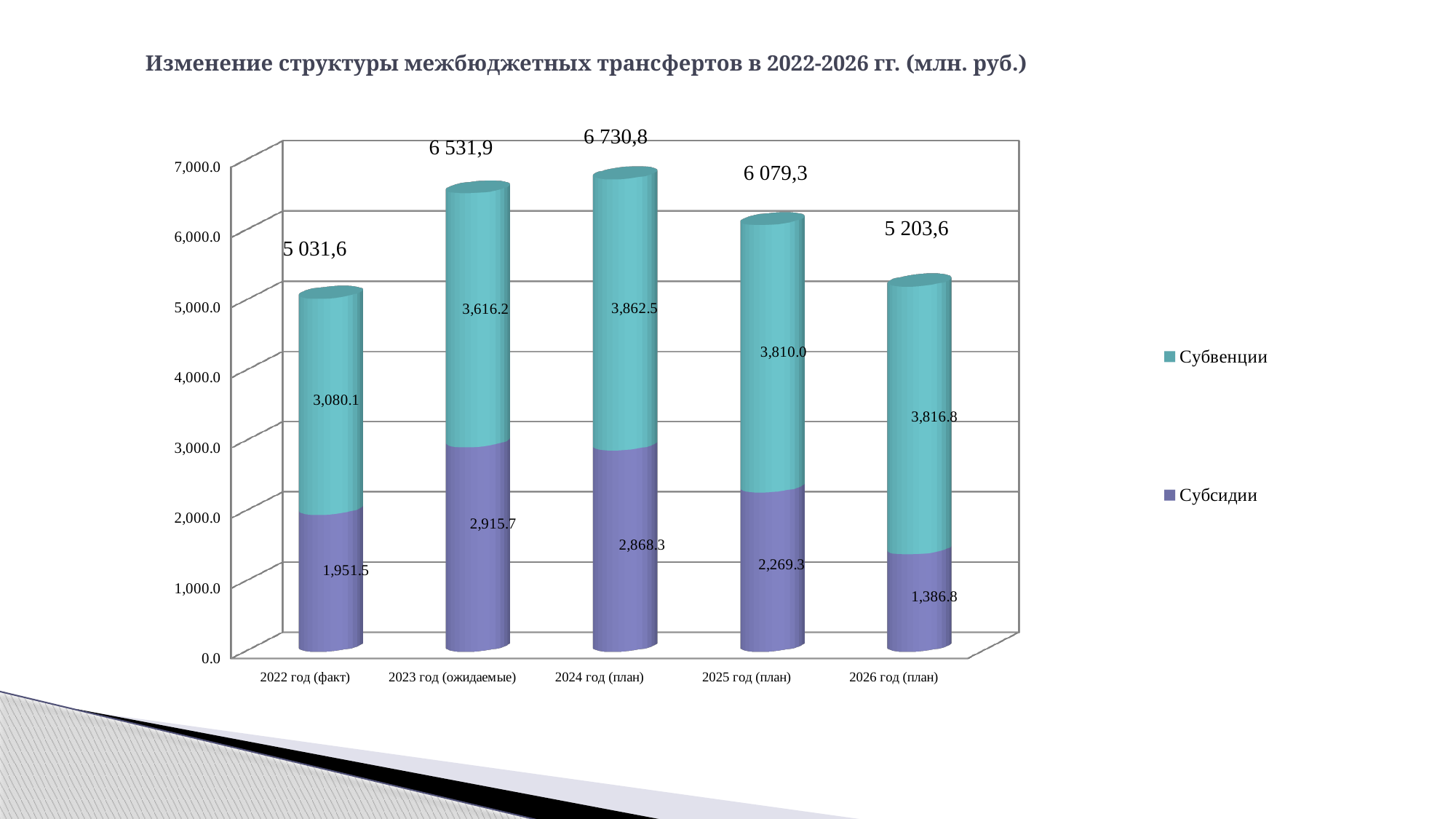
Which series is shown in purple in the legend? Субсидии Which is larger: Субсидии for 2023 год (ожидаемые) or Субсидии for 2025 год (план)? 2023 год (ожидаемые) How many categories are shown on the x axis? 5 What is the value of Субвенции for 2024 год (план)? 3,862.5 What is the difference between the Субвенции values for 2024 год (план) and 2022 год (факт)? 782.4 How many series does the legend list? 2 What is the value of Субсидии for 2022 год (факт)? 1,951.5 Which category has the lowest Субсидии value? 2026 год (план) What is the value of Субсидии for 2026 год (план)? 1,386.8 What kind of chart is shown on the slide? Stacked bar chart What is the total of the stacked bar for 2023 год (ожидаемые)? 6 531,9 Which category has the highest total stacked bar? 2024 год (план)